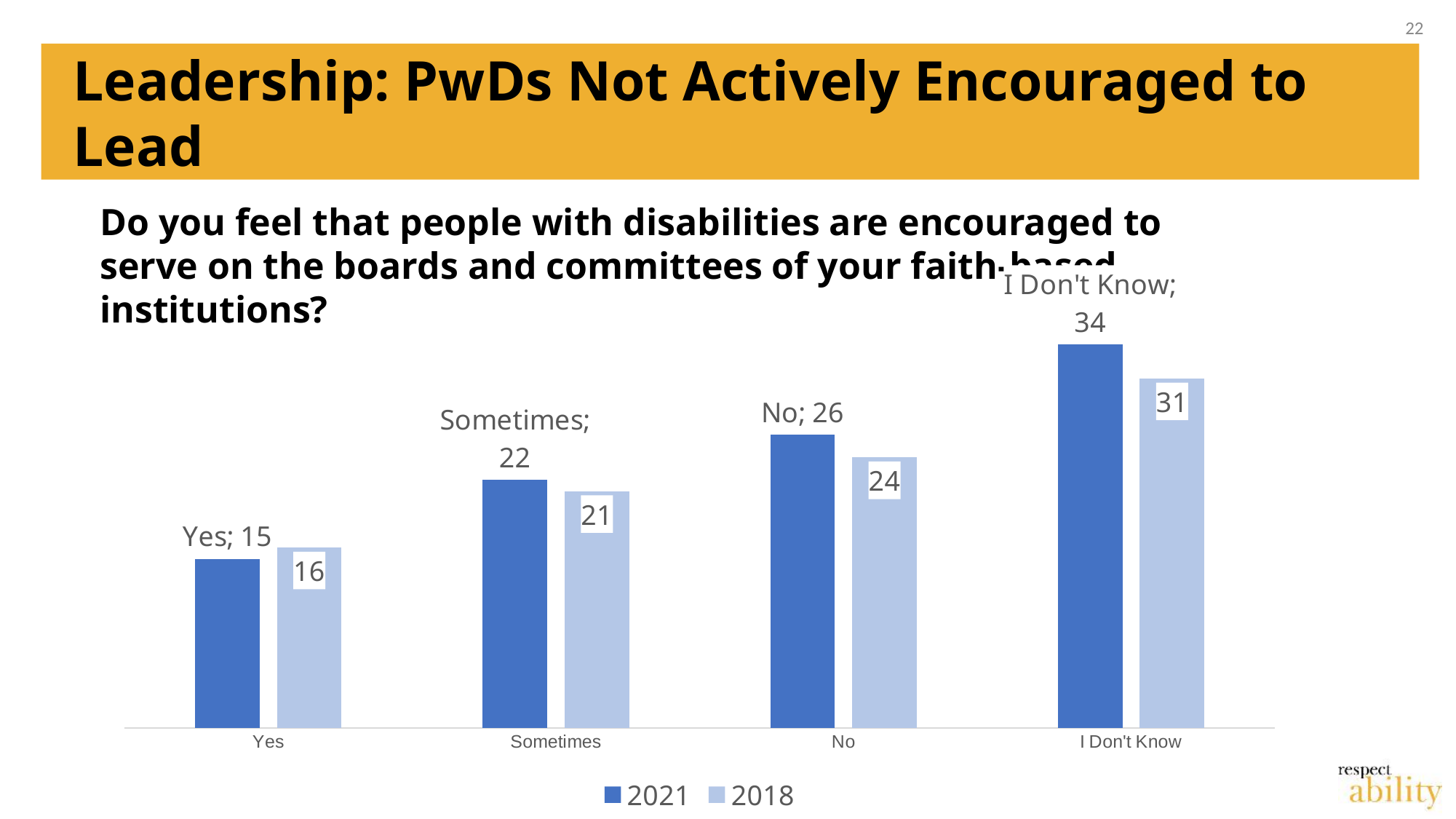
How many categories are shown on the x axis? 4 What is the 2021 value for "I Don't Know"? 34 What is the difference between the 2021 and 2018 values for "No"? 2 Which category has the lowest 2018 value? Yes Which is larger for "Yes": the 2021 value or the 2018 value? 2018 Which category has the highest 2021 value? I Don't Know What is the 2021 value for "Yes"? 15 Do the 2021 values rise or fall from "Yes" to "I Don't Know"? Rise What is the 2018 value for "Sometimes"? 21 What kind of chart is shown on the slide? Bar chart What is the 2018 value for "No"? 24 How many series does the legend list? 2